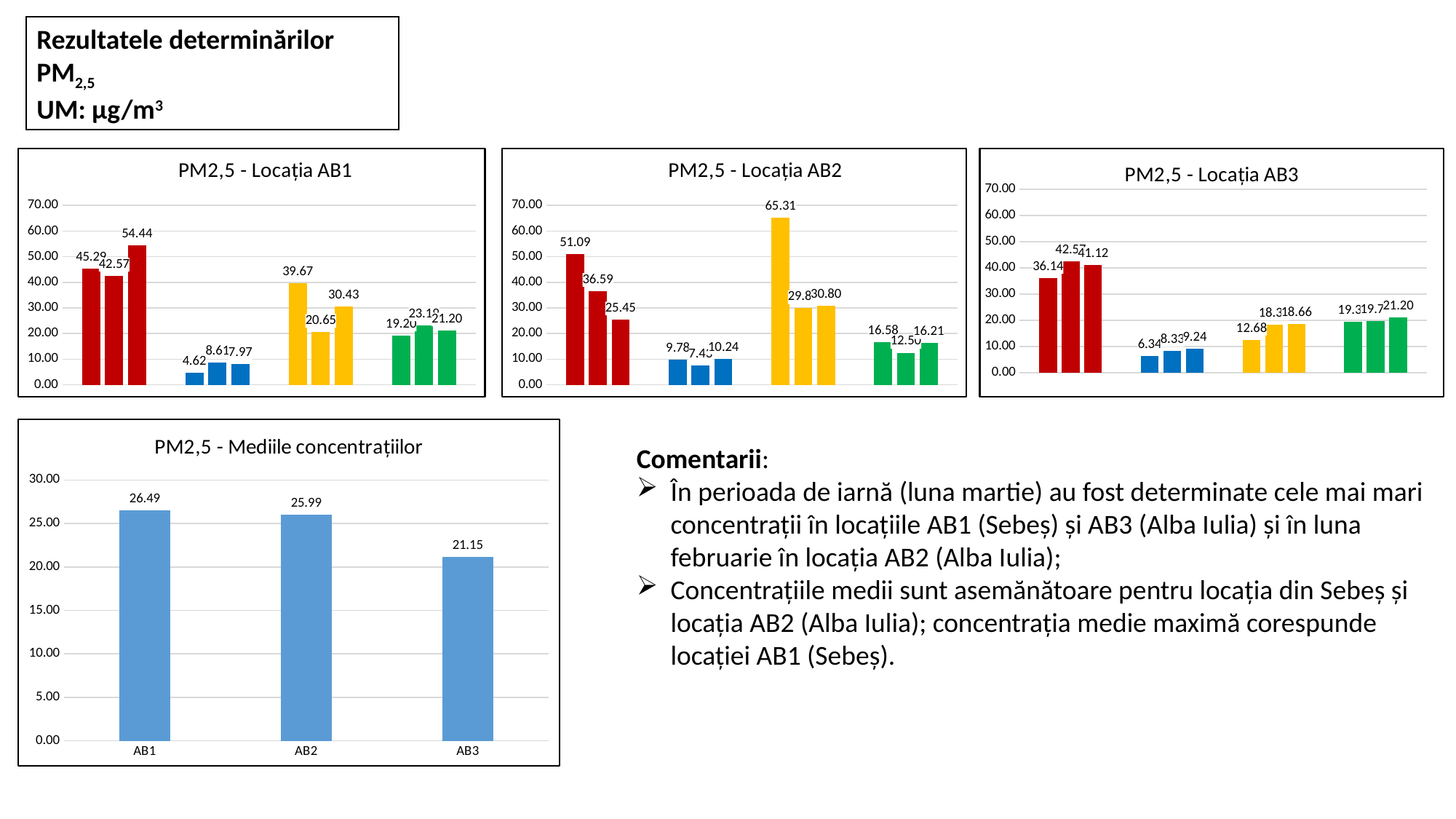
In the PM2,5 - Locația AB2 chart, what is the highest data label shown? 65.31 In the PM2,5 - Mediile concentrațiilor chart, what is the difference between the values for AB1 and AB3? 5.34 In the PM2,5 - Mediile concentrațiilor chart, which is larger, the value for AB2 or the value for AB3? AB2 In the PM2,5 - Mediile concentrațiilor chart, which location has the lowest value? AB3 In the PM2,5 - Mediile concentrațiilor chart, which location has the highest value? AB1 What kind of chart is the PM2,5 - Mediile concentrațiilor chart? bar chart In the PM2,5 - Locația AB1 chart, what is the lowest data label shown? 4.62 In the PM2,5 - Locația AB3 chart, how many bars are plotted? 12 In the PM2,5 - Mediile concentrațiilor chart, what is the value for AB1? 26.49 In the PM2,5 - Mediile concentrațiilor chart, how many locations are shown? 3 In the PM2,5 - Mediile concentrațiilor chart, what is the value for AB3? 21.15 In the PM2,5 - Mediile concentrațiilor chart, do the values rise or fall from AB1 to AB3? fall